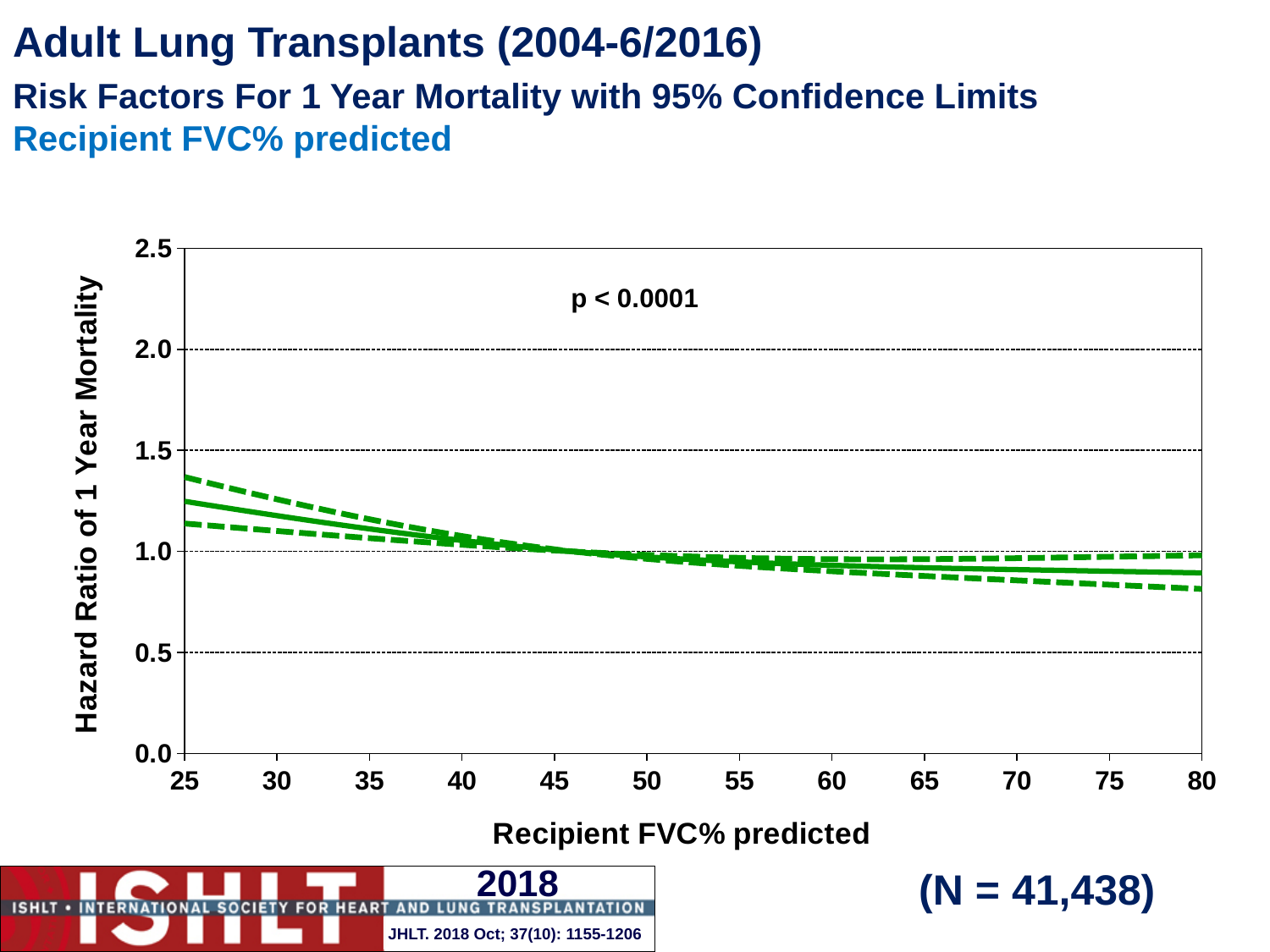
Is the upper 95% confidence limit at a Recipient FVC% predicted of 25 greater or less than 1.5? less Which has the larger hazard ratio: a Recipient FVC% predicted of 30 or of 70? 30 Does the hazard ratio of 1 year mortality rise or fall as Recipient FVC% predicted increases from 25 to 80? fall What kind of chart is shown on the slide? line chart Is the hazard ratio (solid line) at a Recipient FVC% predicted of 80 greater or less than 1.0? less At which Recipient FVC% predicted value shown on the x axis is the hazard ratio highest? 25 At which Recipient FVC% predicted value shown on the x axis is the hazard ratio lowest? 80 Is the hazard ratio (solid line) at a Recipient FVC% predicted of 25 greater or less than 1.0? greater What p-value is printed on the chart? p < 0.0001 How many tick labels are shown on the x axis? 12 What is the sample size (N) shown on the slide? N = 41,438